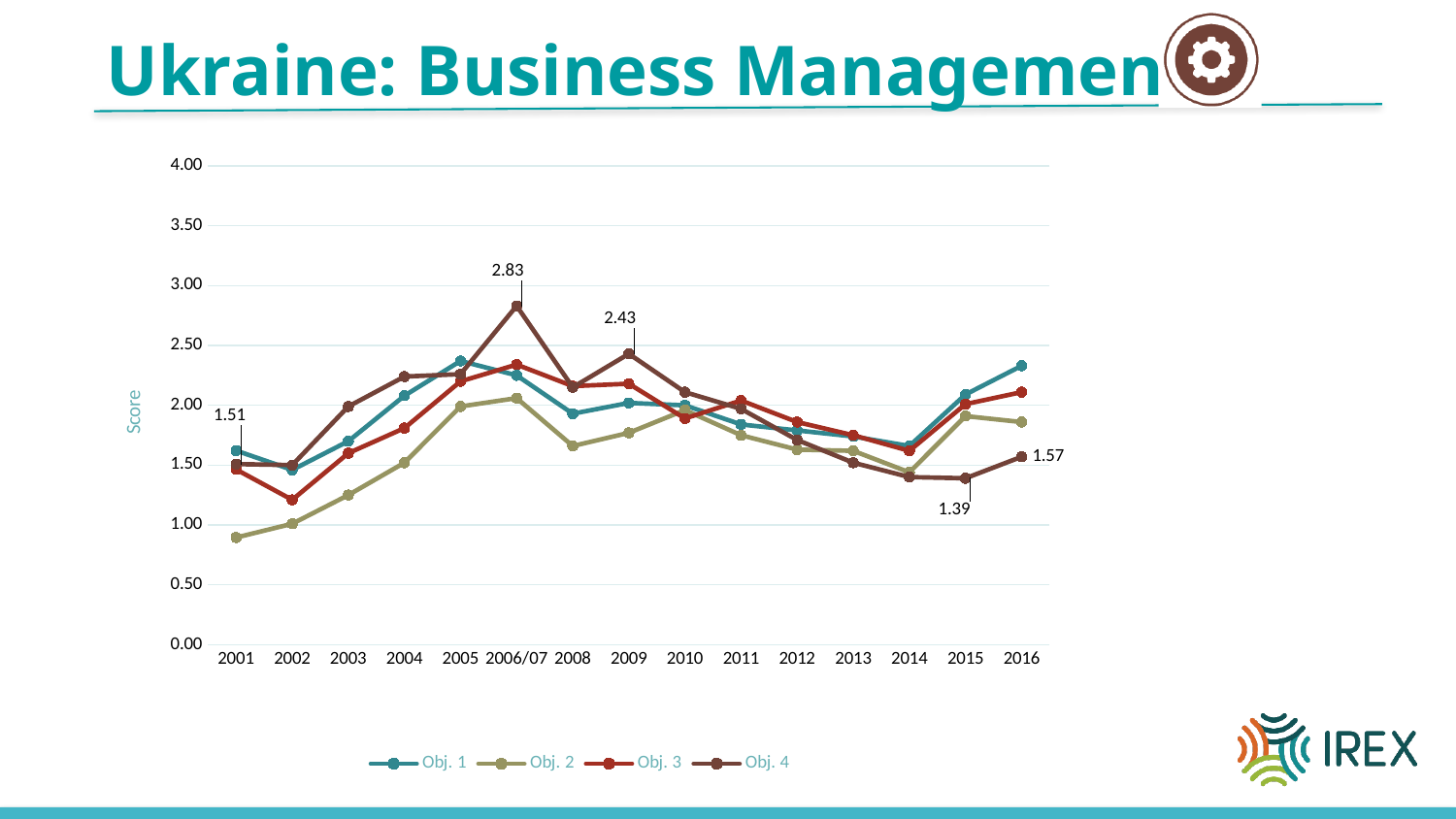
What kind of chart is shown on the slide? line chart What is the difference between the Obj. 4 values in 2006/07 and 2009? 0.40 Is the value for Obj. 2 in 2001 greater or less than 1.00? less How many years are shown along the x axis? 15 What is the value of Obj. 4 in 2015? 1.39 What is the value of Obj. 4 in 2009? 2.43 What is the value of Obj. 4 in 2006/07? 2.83 How many series does the legend list? 4 What is the value of Obj. 4 in 2016? 1.57 Is the value for Obj. 1 in 2016 greater or less than 2.00? greater In which year does Obj. 4 reach its highest value? 2006/07 What is the label on the vertical axis? Score